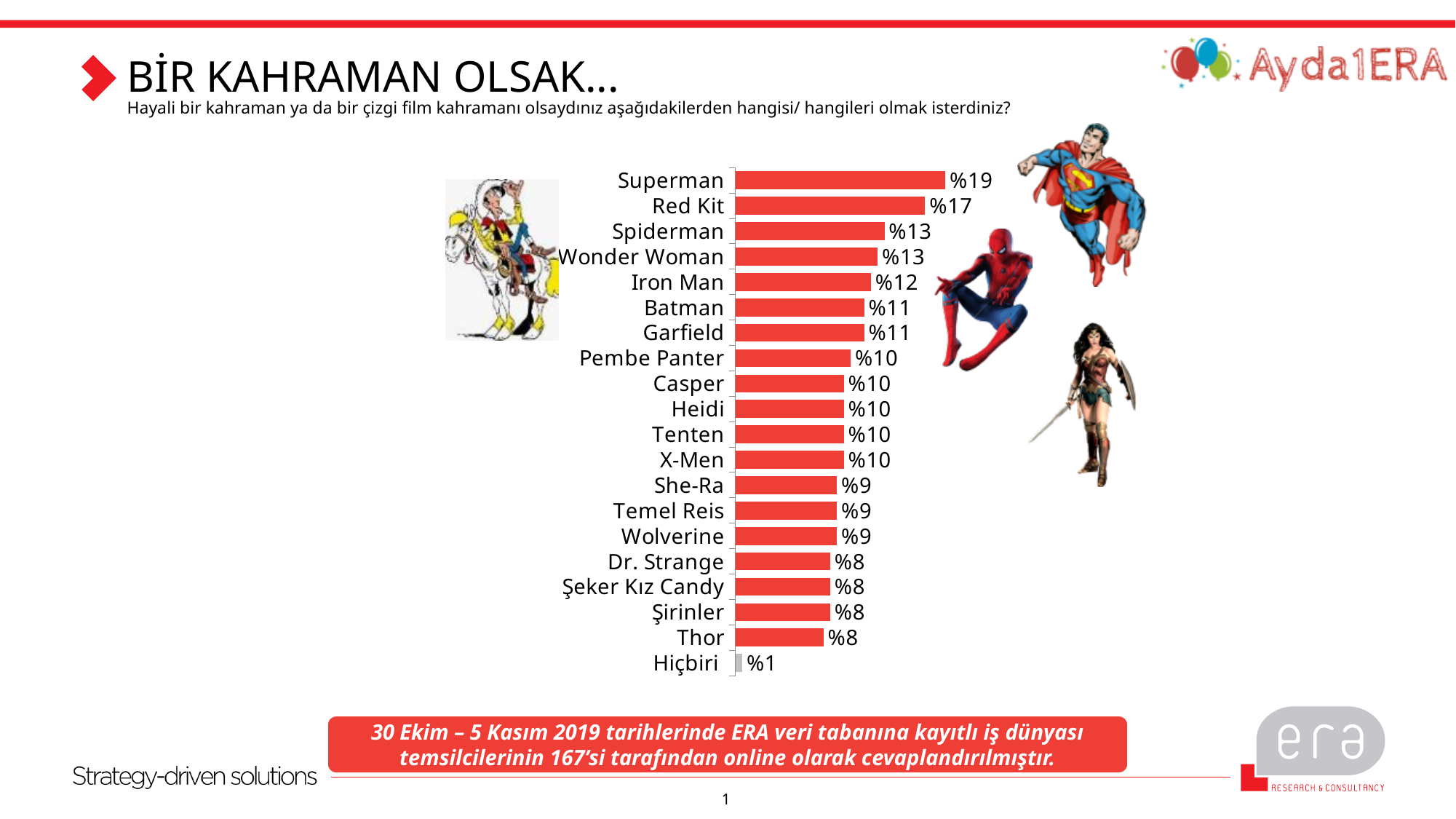
What is the difference between the values for Superman and Red Kit? %2 Which is larger, the value for Spiderman or the value for Batman? Spiderman What is the value for Superman? %19 What colour is the bar for Hiçbiri? Grey Which category has the highest value? Superman How many categories are shown in the chart? 20 What kind of chart is shown on the slide? Bar chart What is the value for Thor? %8 Which category has the lowest value? Hiçbiri What is the value for Red Kit? %17 What is the difference between the values for Iron Man and Thor? %4 What is the value for Garfield? %11